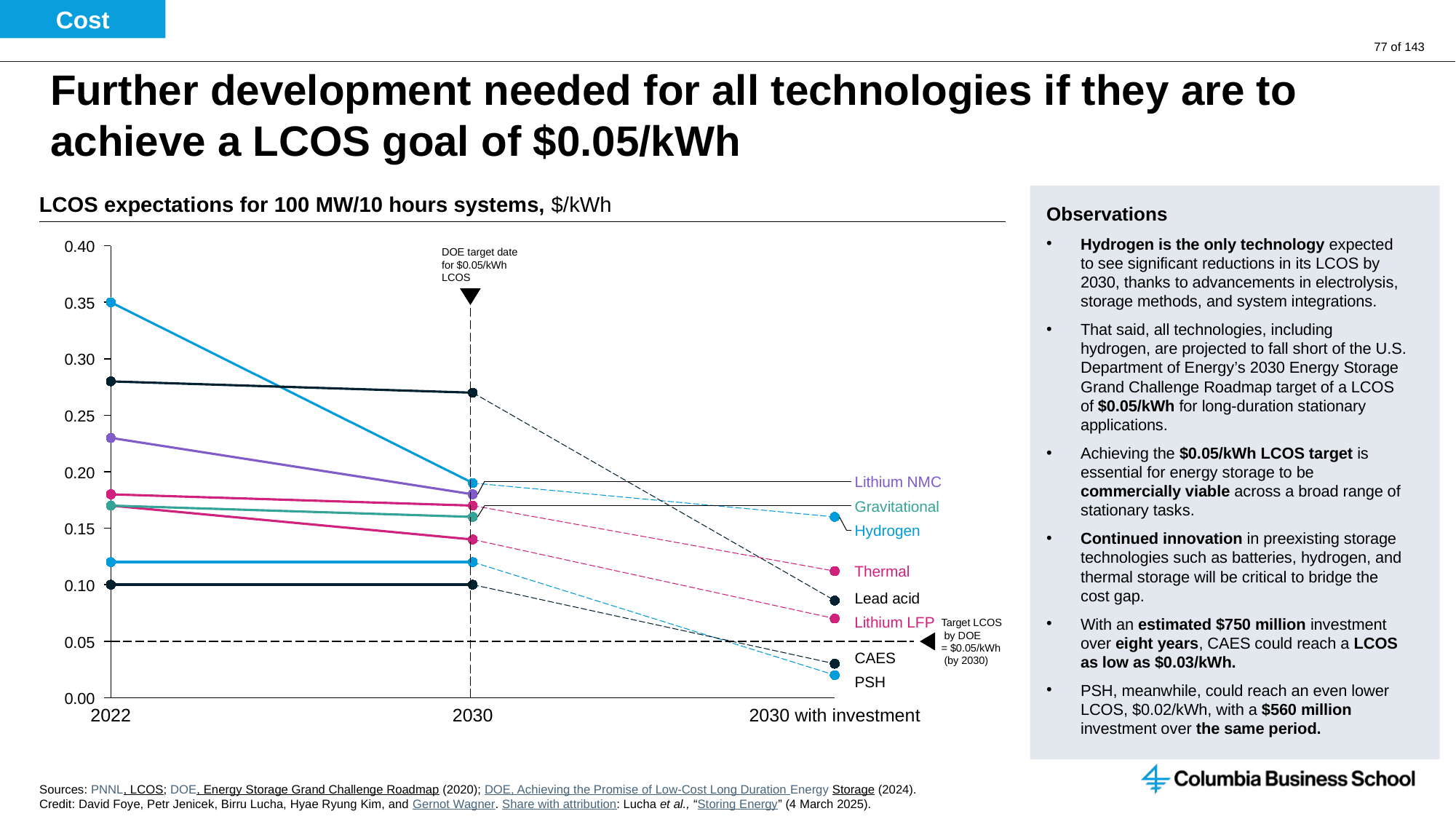
What is the LCOS value for Hydrogen in 2022? 0.35 Does the LCOS for Hydrogen rise or fall from 2022 to 2030? fall Is the LCOS value for Lead acid in the '2030 with investment' scenario greater or less than 0.05? greater What kind of chart is shown on the slide? line chart Which technology has the lowest LCOS in the '2030 with investment' scenario? PSH How many technologies are plotted in the chart? 8 How many points are shown along the x axis of the chart? 3 Is the LCOS value for CAES in the '2030 with investment' scenario greater or less than 0.05? less What is the LCOS value for CAES in 2022? 0.10 In 2022, which has the higher LCOS: Lead acid or Lithium NMC? Lead acid Which technology has the highest LCOS in 2022? Hydrogen Is the LCOS value for Lithium NMC in 2022 greater or less than 0.20? greater